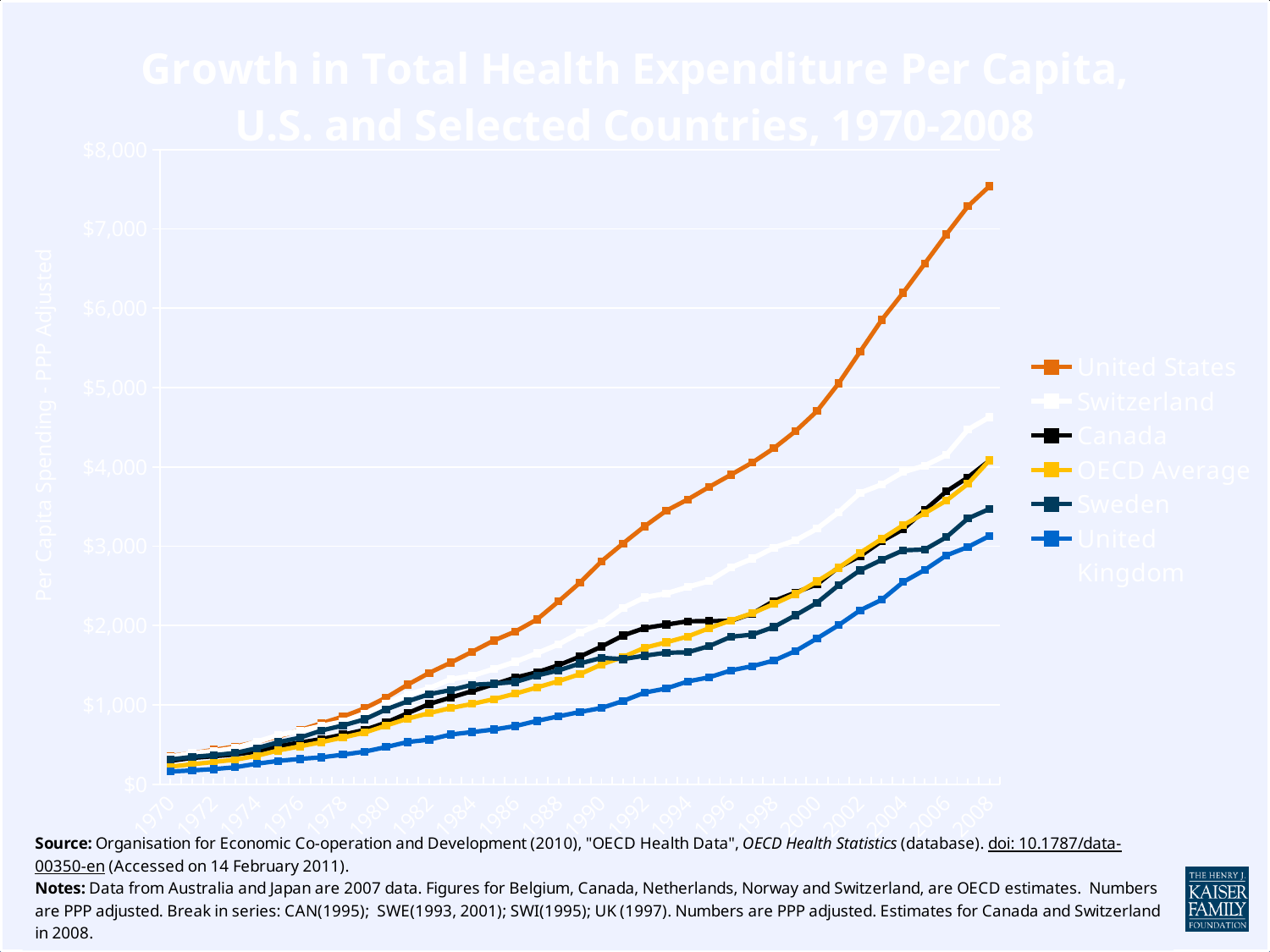
What kind of chart is shown on the slide? line chart Is the value for the United States in 2008 greater or less than $7,000? greater Is the value for Sweden in 2008 greater or less than $4,000? less Do the values for the United States rise or fall from 1970 to 2008? rise How many series does the legend list? 6 What colour is the line for the United States? orange Is the value for the United States in 2000 greater or less than $4,000? greater In 2008, which is larger: the value for the United States or the value for Switzerland? United States Which country has the highest per capita health spending in 2008? United States Which series has the lowest per capita health spending in 2008? United Kingdom